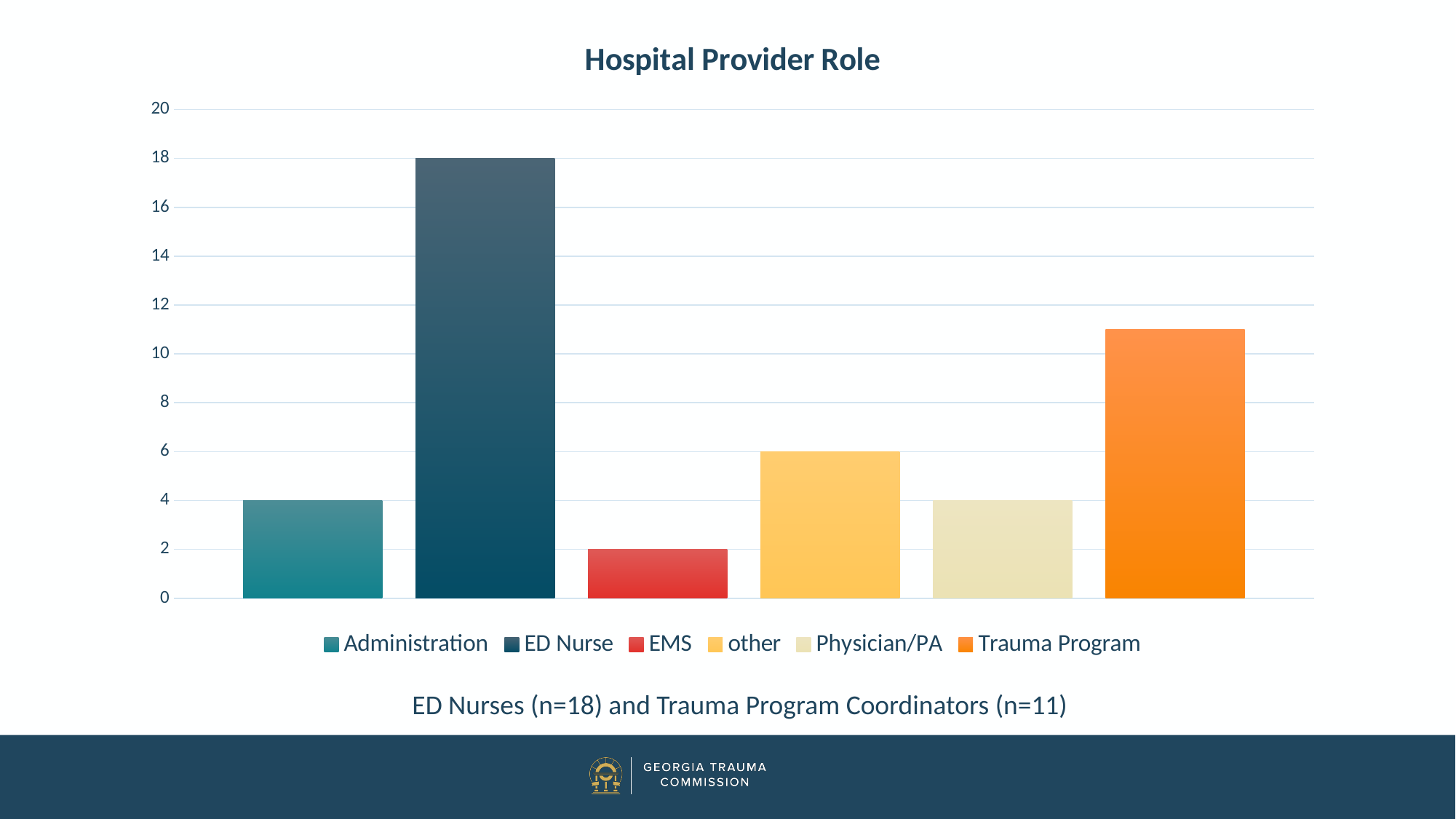
Which provider role has the lowest value? EMS What is the value for ED Nurse? 18 How many entries does the legend list? 6 Which provider role has the highest value? ED Nurse What is the title of the chart? Hospital Provider Role What is the difference between the values for ED Nurse and other? 12 Is the value for Trauma Program greater or less than 10? greater What is the value for Administration? 4 Which is larger, the value for other or the value for Physician/PA? other What is the value for EMS? 2 What is the value for other? 6 What type of chart is shown on the slide? bar chart